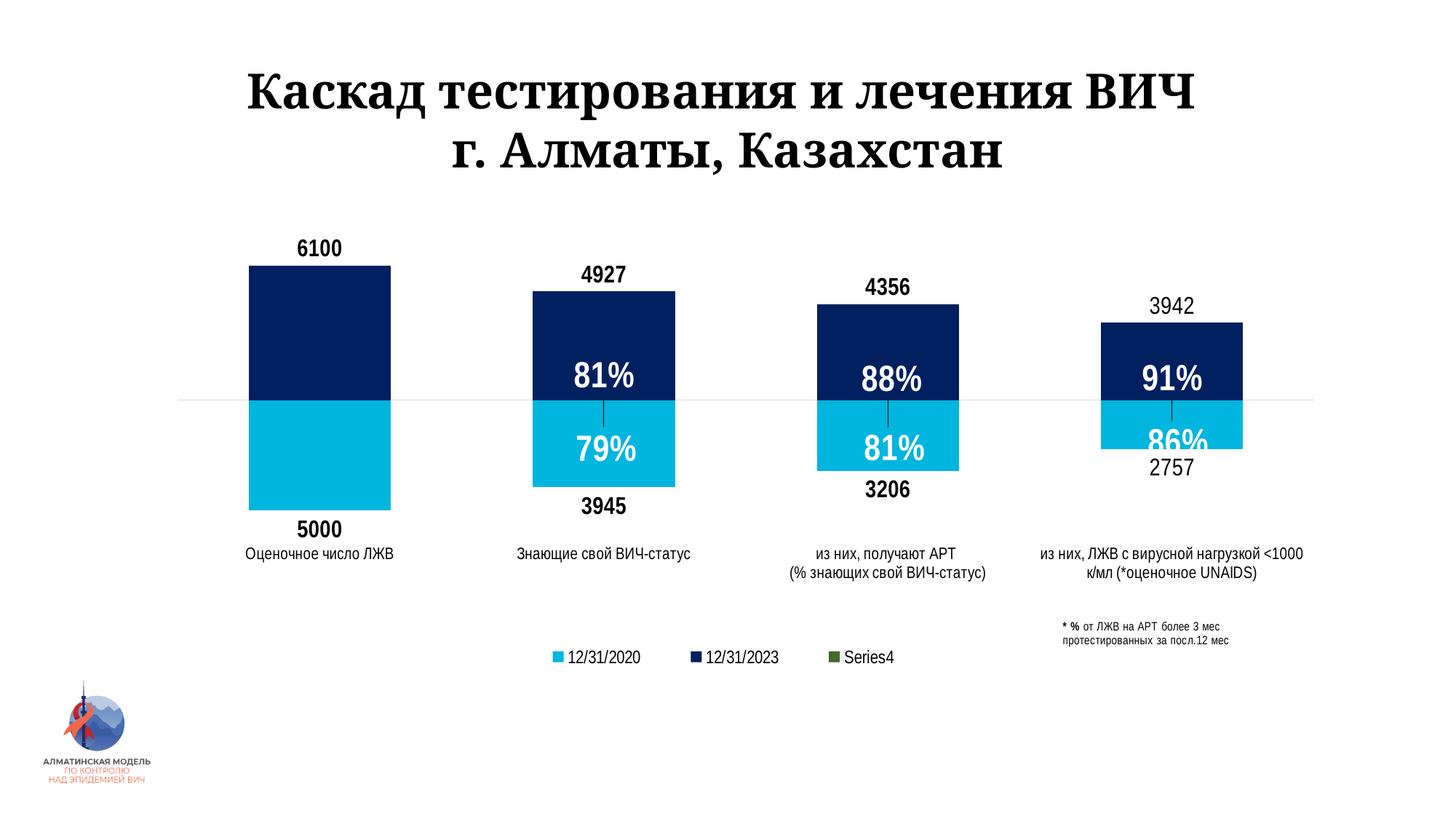
How many series does the legend list? 3 What is the 12/31/2020 value for "Оценочное число ЛЖВ"? 5000 What is the difference between the 12/31/2023 and 12/31/2020 values for "Знающие свой ВИЧ-статус"? 982 What is the 12/31/2020 value for "из них, получают АРТ"? 3206 What is the 12/31/2023 value for "Оценочное число ЛЖВ"? 6100 Which is larger for "из них, получают АРТ": the 12/31/2020 value or the 12/31/2023 value? 12/31/2023 Which category has the highest 12/31/2023 value? Оценочное число ЛЖВ What is the 12/31/2023 value for "Знающие свой ВИЧ-статус"? 4927 Which category has the lowest 12/31/2020 value? из них, ЛЖВ с вирусной нагрузкой <1000 к/мл What is the 12/31/2023 value for "из них, ЛЖВ с вирусной нагрузкой <1000 к/мл"? 3942 How many categories are shown on the x axis? 4 What kind of chart is shown on the slide? Bar chart